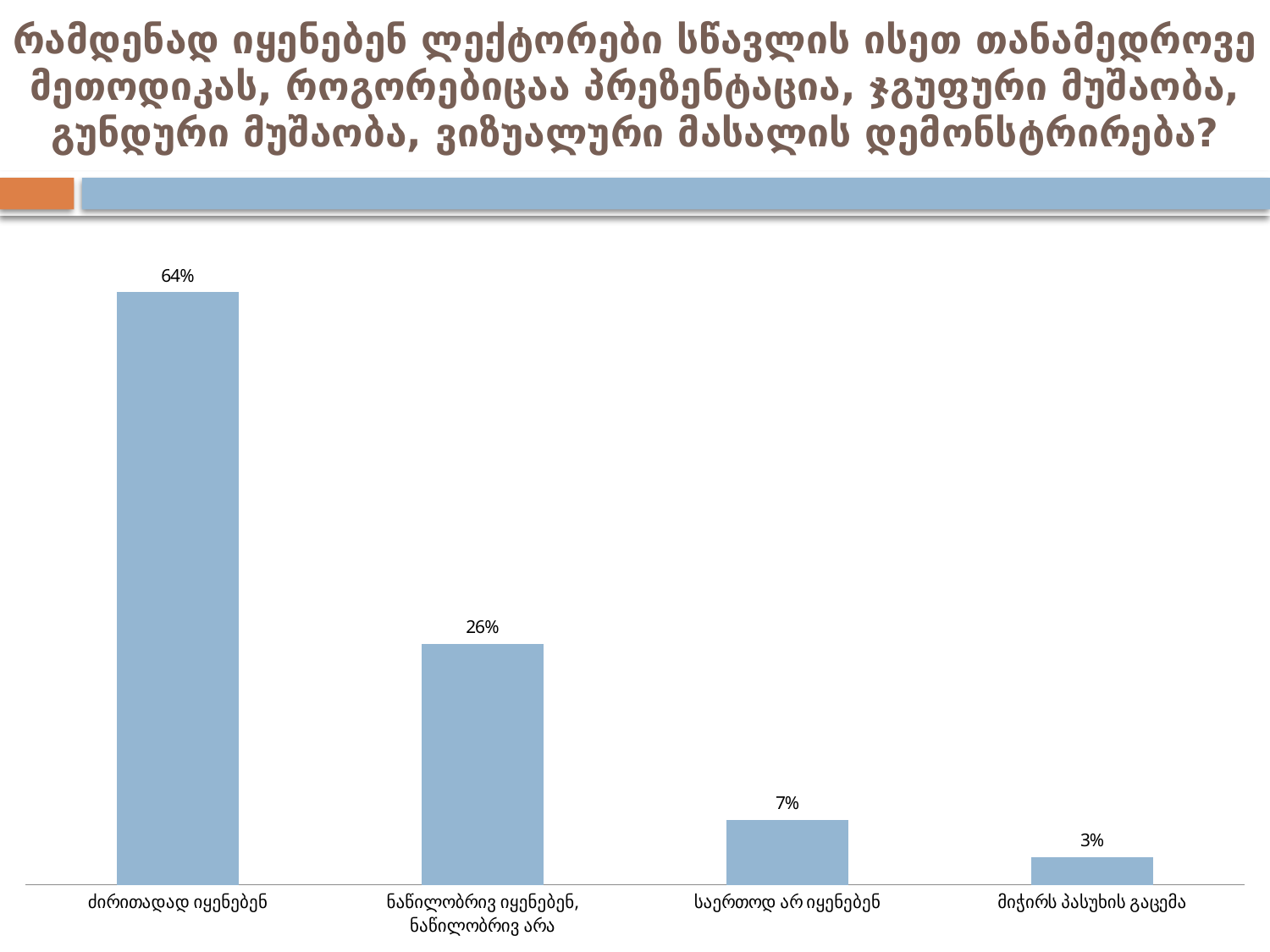
What is the difference between the values for "ძირითადად იყენებენ" and "ნაწილობრივ იყენებენ, ნაწილობრივ არა"? 38% What is the difference between the values for "საერთოდ არ იყენებენ" and "მიჭირს პასუხის გაცემა"? 4% What value is shown for the category "ნაწილობრივ იყენებენ, ნაწილობრივ არა"? 26% Do the values rise or fall from left to right along the x axis? fall What value is shown for the category "ძირითადად იყენებენ"? 64% What value is shown for the category "მიჭირს პასუხის გაცემა"? 3% Which category has the highest value? ძირითადად იყენებენ What value is shown for the category "საერთოდ არ იყენებენ"? 7% Which category has the lowest value? მიჭირს პასუხის გაცემა What kind of chart is shown on the slide? bar chart How many categories are shown on the chart? 4 Which is larger: the value for "ნაწილობრივ იყენებენ, ნაწილობრივ არა" or the value for "საერთოდ არ იყენებენ"? ნაწილობრივ იყენებენ, ნაწილობრივ არა